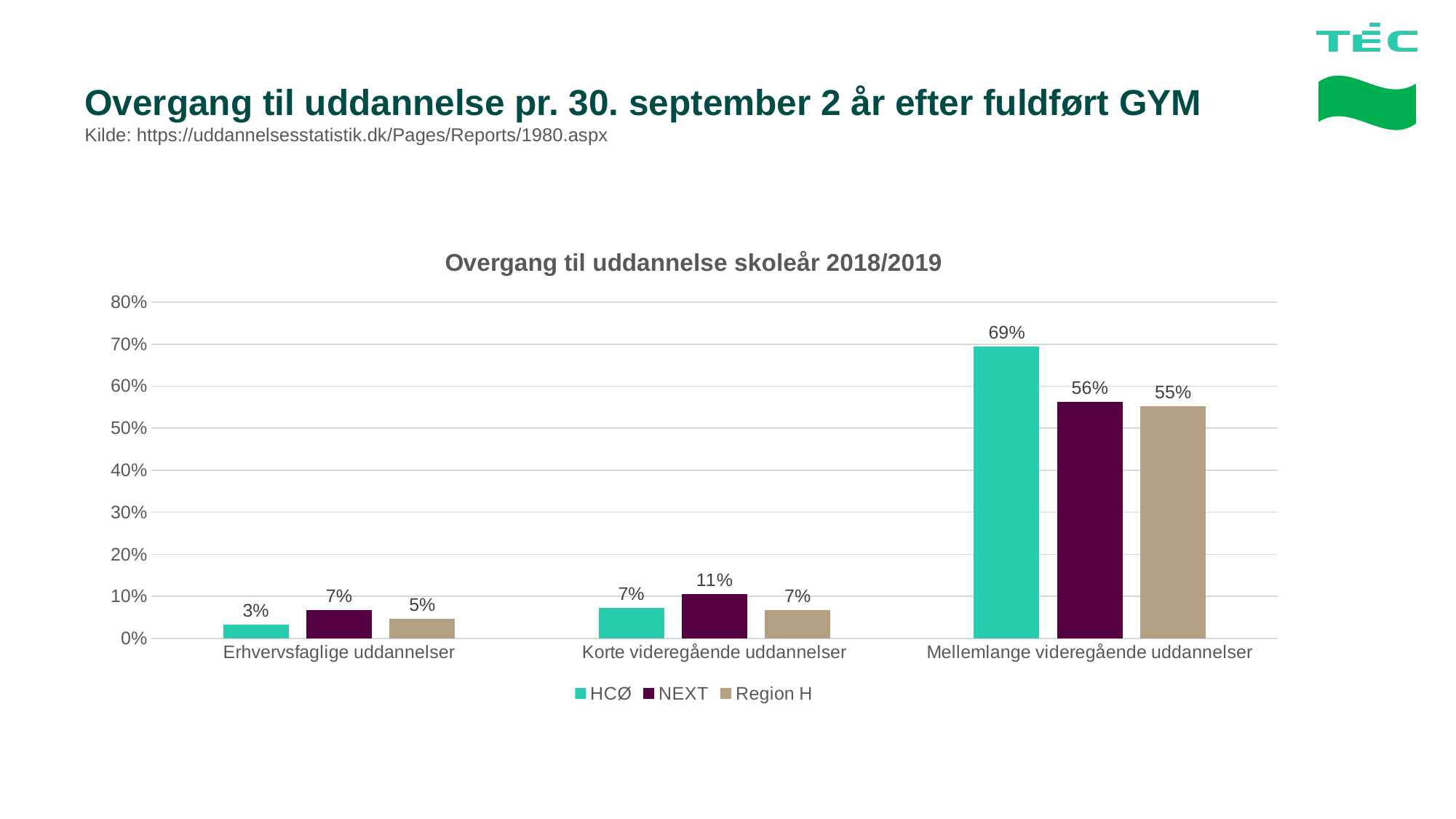
What is the value for HCØ in the Mellemlange videregående uddannelser category? 69% What is the value for Region H in the Erhvervsfaglige uddannelser category? 5% Which is larger for Korte videregående uddannelser: the NEXT value or the Region H value? NEXT How many categories are shown on the x axis? 3 Which series has the highest value in the Mellemlange videregående uddannelser category? HCØ How many series does the legend list? 3 What is the value for NEXT in the Korte videregående uddannelser category? 11% What kind of chart is shown on the slide? Bar chart What is the title of the chart? Overgang til uddannelse skoleår 2018/2019 Is the value for HCØ in Mellemlange videregående uddannelser greater or less than 60%? greater What is the difference between the HCØ and NEXT values for Mellemlange videregående uddannelser? 13% Which series has the lowest value in the Erhvervsfaglige uddannelser category? HCØ